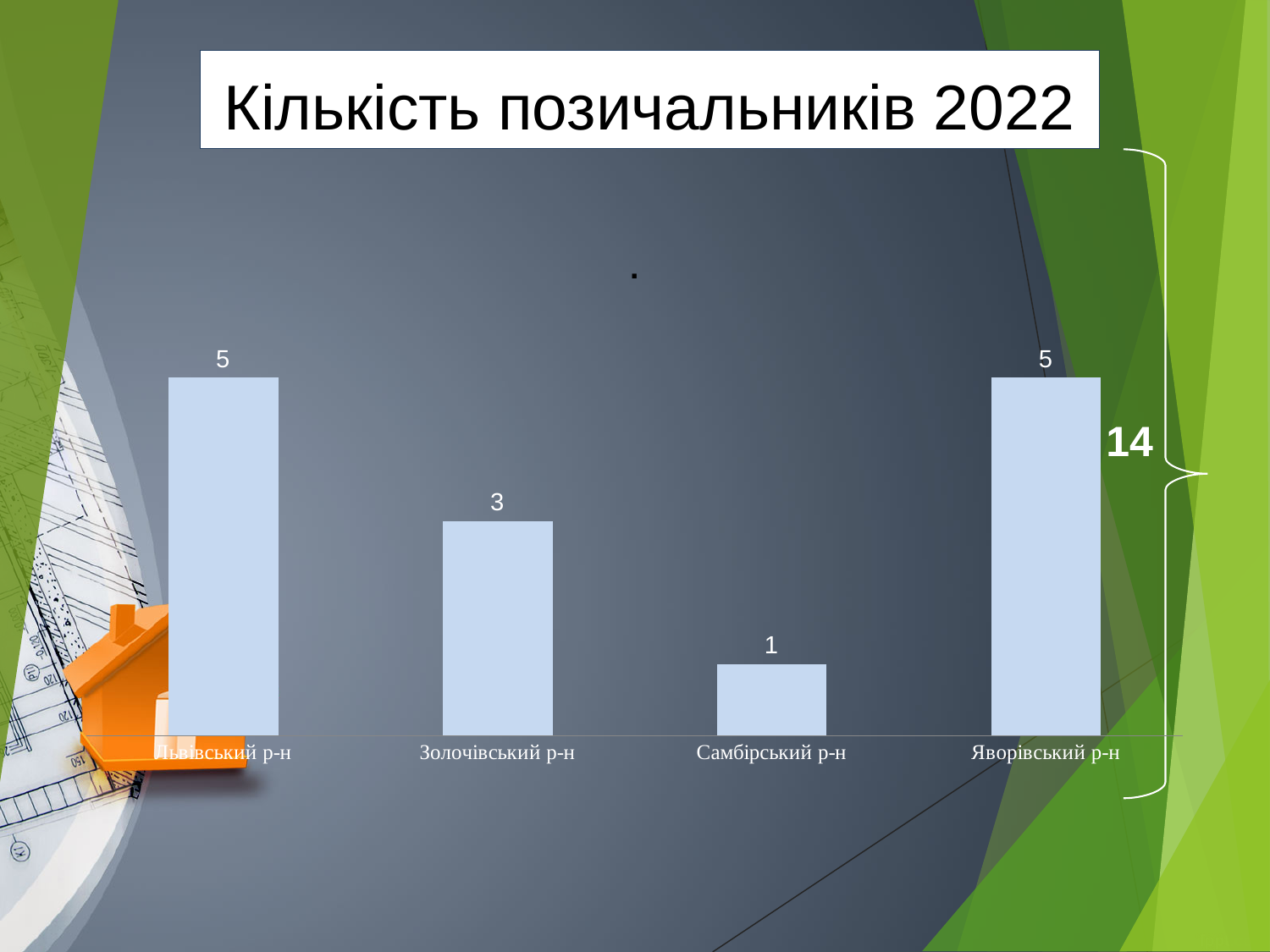
What is the value for Самбірський р-н? 1 How many districts are shown in the chart? 4 What is the value for Золочівський р-н? 3 What is the value for Яворівський р-н? 5 What is the title of the chart? Кількість позичальників 2022 What is the value for Львівський р-н? 5 Which is larger, the value for Золочівський р-н or the value for Самбірський р-н? Золочівський р-н What total is shown by the bracket to the right of the chart? 14 What kind of chart is shown on the slide? Bar chart What is the difference between the values for Львівський р-н and Золочівський р-н? 2 Which district has the lowest number of borrowers? Самбірський р-н What is the difference between the values for Золочівський р-н and Самбірський р-н? 2